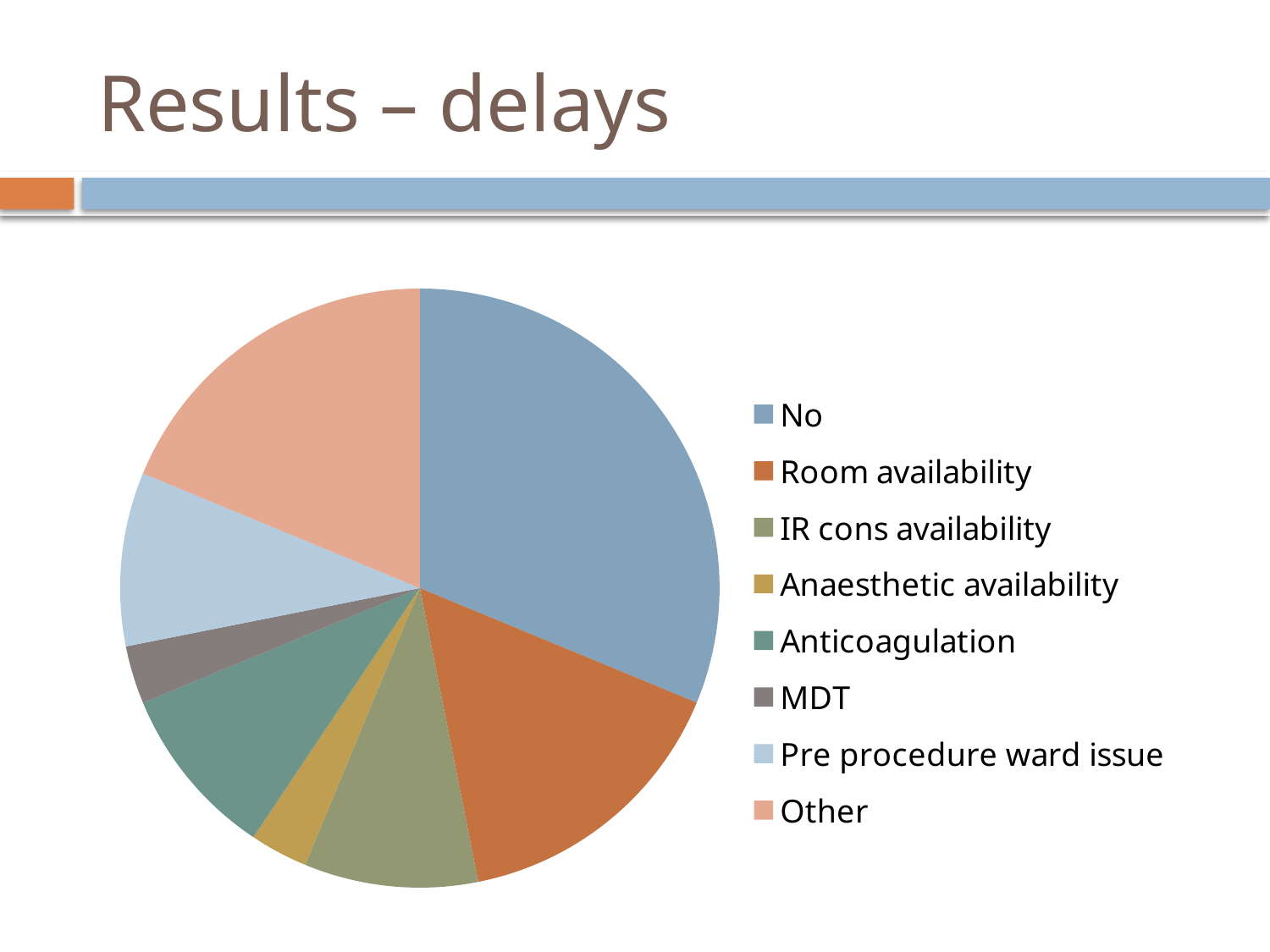
What kind of chart is shown on the slide? pie chart How many slices does the pie chart have? 8 Which category has the largest slice of the pie chart? No Which slice is larger, Room availability or IR cons availability? Room availability Which category is shown in the legend immediately after Anticoagulation? MDT Which slice is larger, Anticoagulation or MDT? Anticoagulation What is the title of the slide containing the pie chart? Results – delays Which slice is larger, Other or Pre procedure ward issue? Other